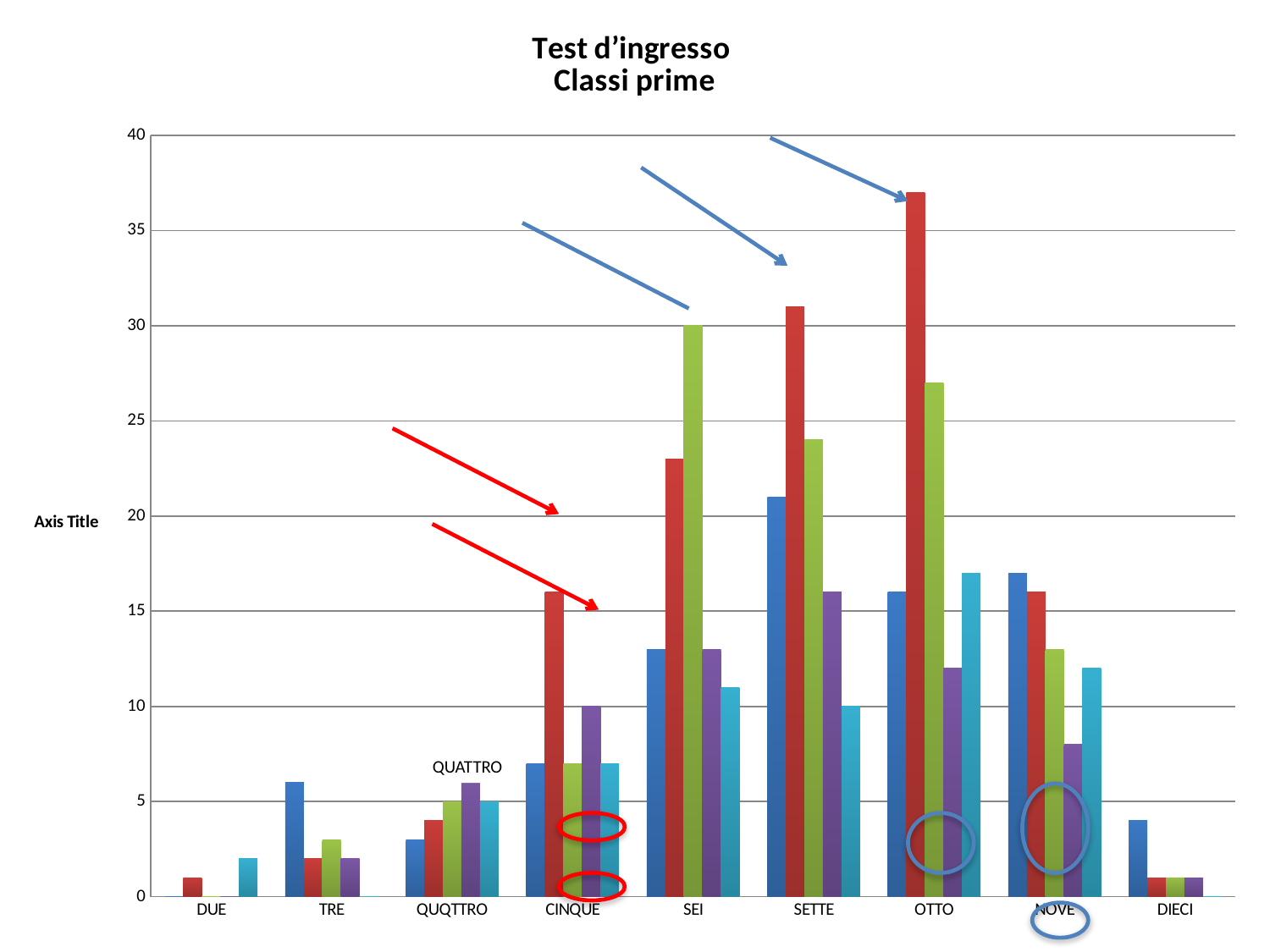
Is the value of the blue bar for SETTE greater or less than 20? greater How many categories are shown on the x axis of the chart? 9 Is the value of the blue bar for DIECI greater or less than 5? less Which is larger, the red bar for OTTO or the red bar for SETTE? the red bar for OTTO What is the label of the vertical axis? Axis Title Is the value of the red bar for OTTO greater or less than 35? greater What is the title of the chart? Test d'ingresso Classi prime What kind of chart is shown on the slide? bar chart Which category contains the tallest bar in the chart? OTTO Which is larger, the green bar for SEI or the green bar for SETTE? the green bar for SEI